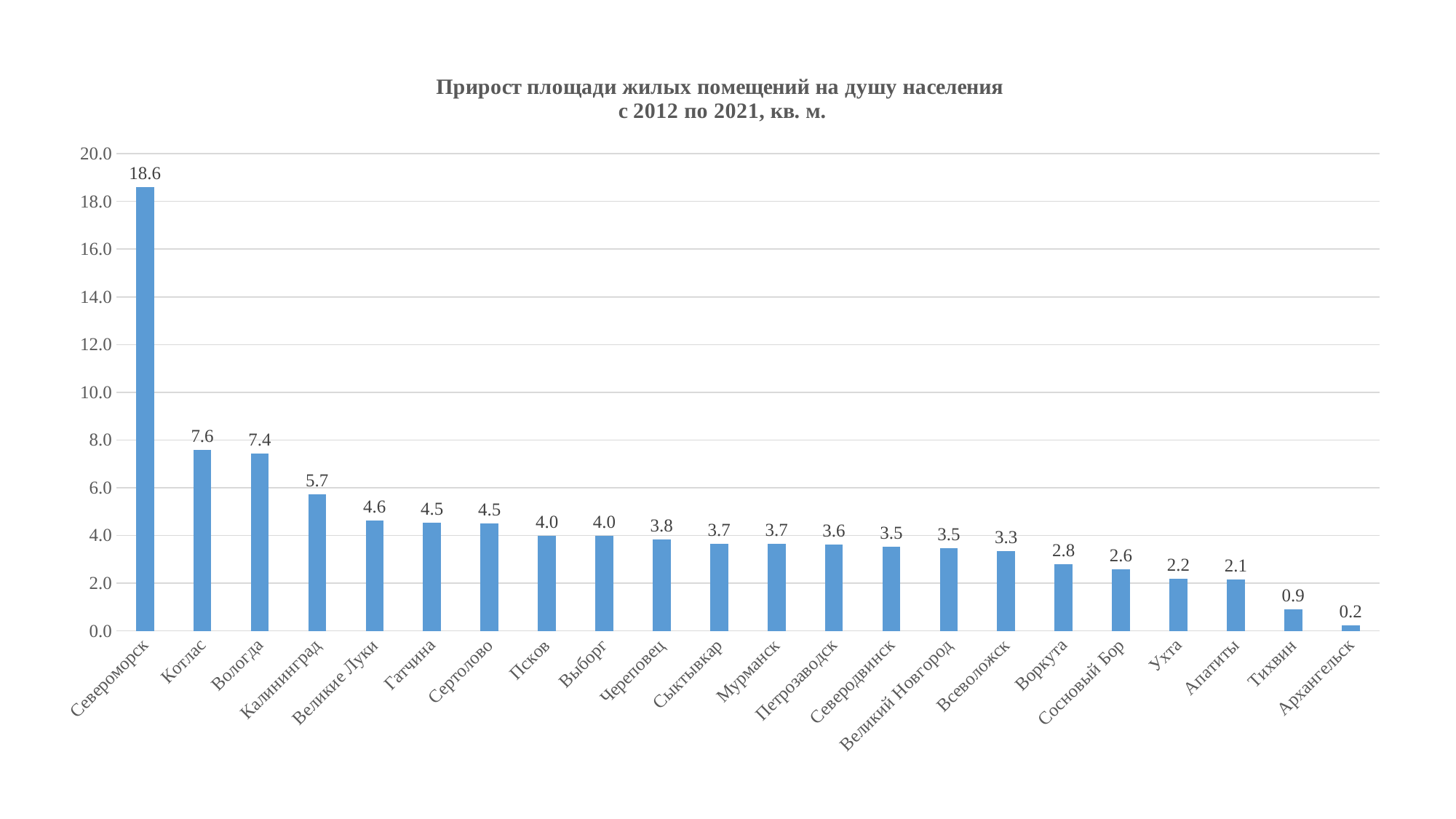
What is the difference between the values for Североморск and Котлас? 11.0 Do the values rise or fall from left to right along the x axis? fall What is the difference between the values for Котлас and Вологда? 0.2 What is the value for Североморск? 18.6 How many cities are shown on the chart? 22 What is the value for Калининград? 5.7 Which city has the highest value? Североморск Which city has the lowest value? Архангельск What kind of chart is this? bar chart What is the value for Воркута? 2.8 Which is larger, the value for Ухта or the value for Тихвин? Ухта Is the value for Вологда greater or less than 6.0? greater